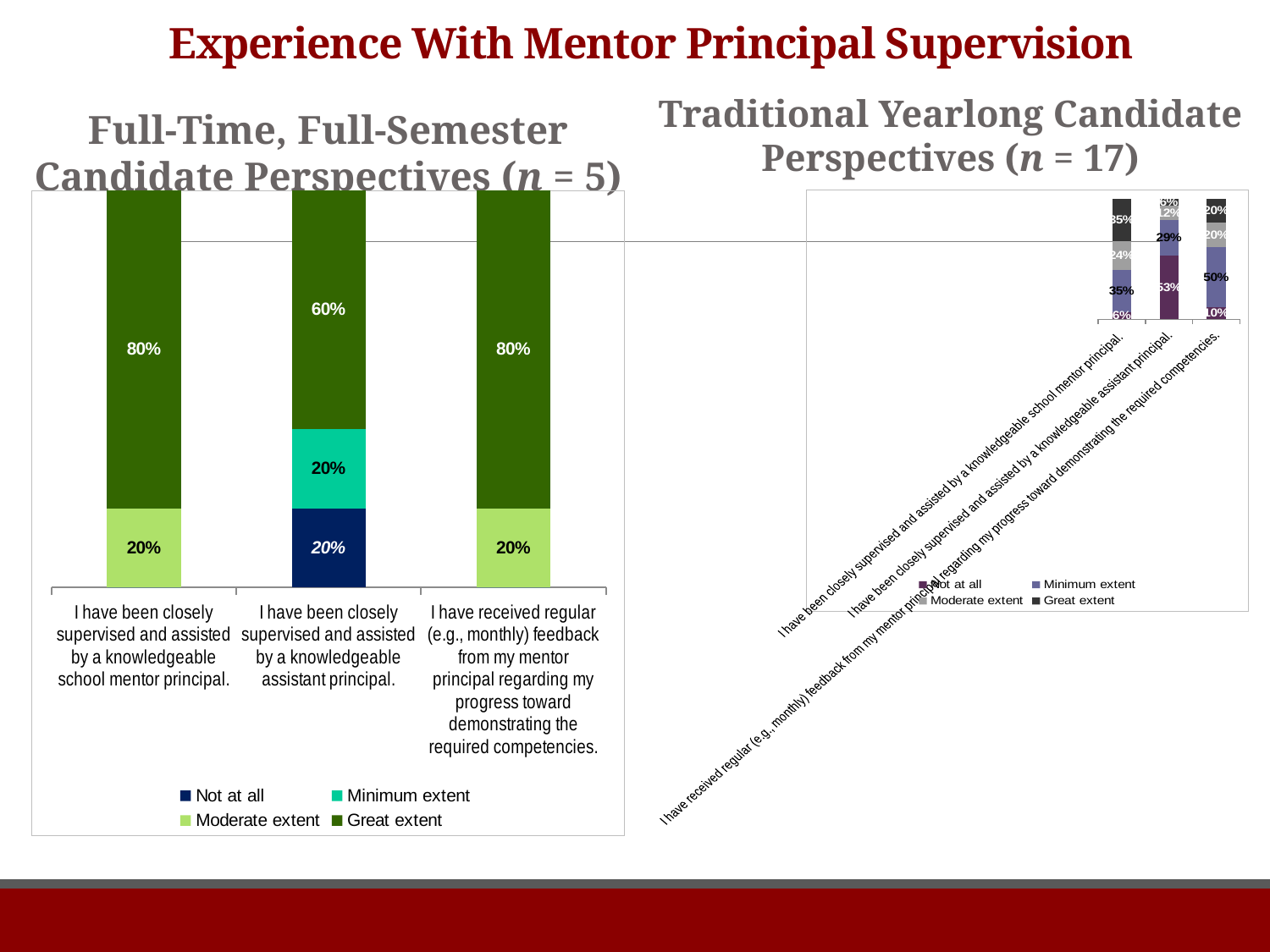
In the Full-Time, Full-Semester Candidate Perspectives chart, what percentage reported a moderate extent for receiving regular feedback from their mentor principal? 20% In the Traditional Yearlong Candidate Perspectives chart, what percentage reported 'Not at all' for being closely supervised and assisted by a knowledgeable assistant principal? 53% In the Traditional Yearlong Candidate Perspectives chart, what percentage reported a minimum extent for receiving regular feedback from their mentor principal? 50% In the Full-Time, Full-Semester Candidate Perspectives chart, which statement has the lowest 'Great extent' percentage? I have been closely supervised and assisted by a knowledgeable assistant principal. In the Full-Time, Full-Semester Candidate Perspectives chart, what is the difference between the 'Great extent' percentage for the school mentor principal statement and the assistant principal statement? 20% How many series does the legend of the Full-Time, Full-Semester Candidate Perspectives chart list? 4 In the Full-Time, Full-Semester Candidate Perspectives chart, what percentage reported 'Not at all' for being closely supervised and assisted by a knowledgeable assistant principal? 20% In the Full-Time, Full-Semester Candidate Perspectives chart, how many statements (categories) are shown on the x axis? 3 In the Full-Time, Full-Semester Candidate Perspectives chart, what is the total of the 'Not at all' and 'Minimum extent' segments for the assistant principal statement? 40% In the Full-Time, Full-Semester Candidate Perspectives chart, what percentage reported a great extent for being closely supervised and assisted by a knowledgeable assistant principal? 60% In the Full-Time, Full-Semester Candidate Perspectives chart, what percentage of candidates reported a great extent for being closely supervised and assisted by a knowledgeable school mentor principal? 80% What type of chart is the Full-Time, Full-Semester Candidate Perspectives chart? Stacked bar chart